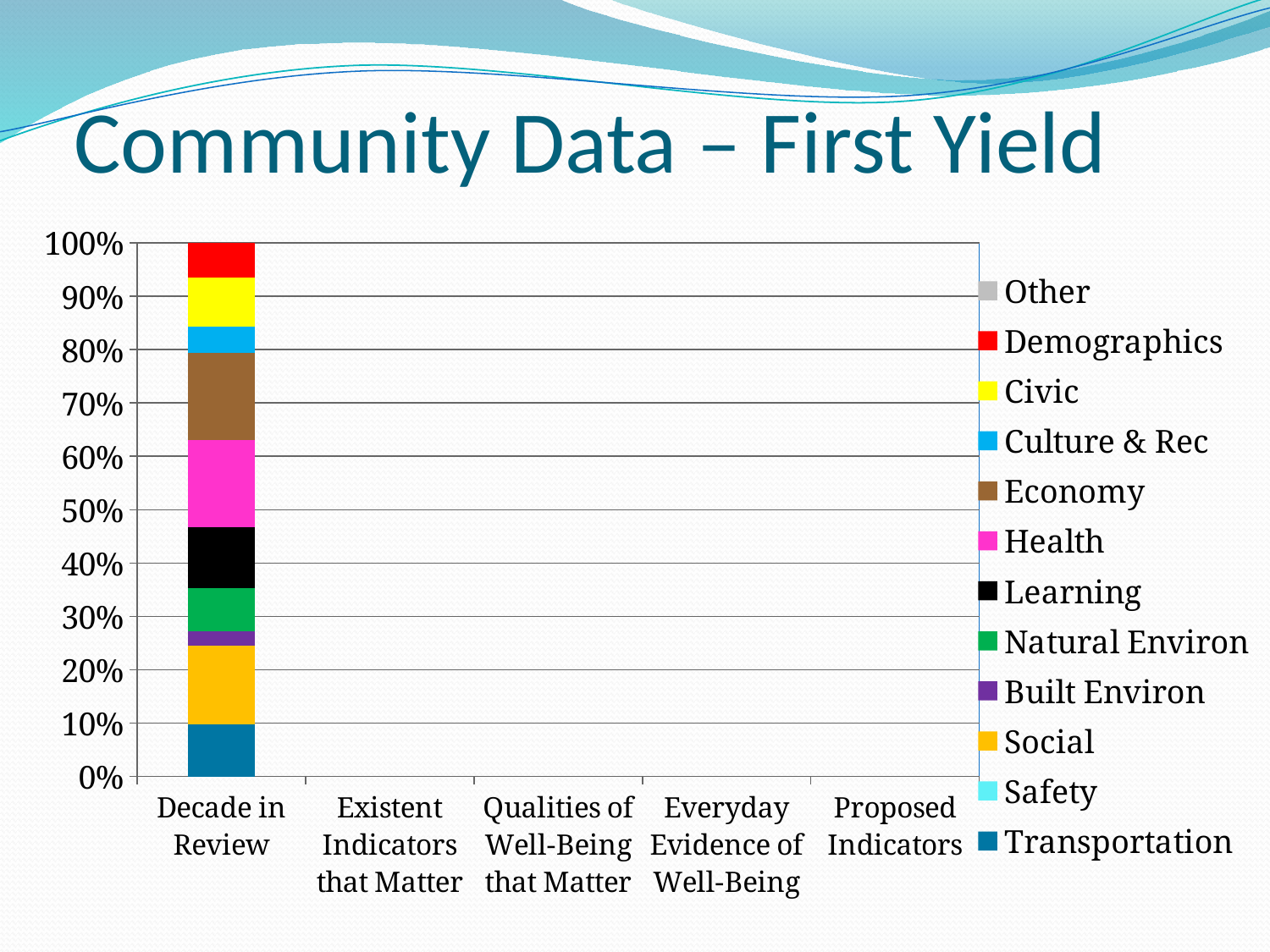
How many categories are listed along the x axis? 5 How many series does the legend list? 12 Is the Transportation segment of the Decade in Review bar greater or less than 20% of the bar? less Which series is at the bottom of the Decade in Review stacked bar? Transportation Which visible segment of the Decade in Review bar is the smallest? Built Environ What is the total height of the stacked bar for Decade in Review? 100% In the Decade in Review bar, which is larger, the Economy segment or the Built Environ segment? Economy In the Decade in Review bar, which is larger, the Health segment or the Culture & Rec segment? Health What is the title of the slide? Community Data – First Yield What kind of chart is shown on the slide? Stacked bar chart Is the Social segment of the Decade in Review bar greater or less than 10% of the bar? greater Which category on the x axis has a plotted bar? Decade in Review